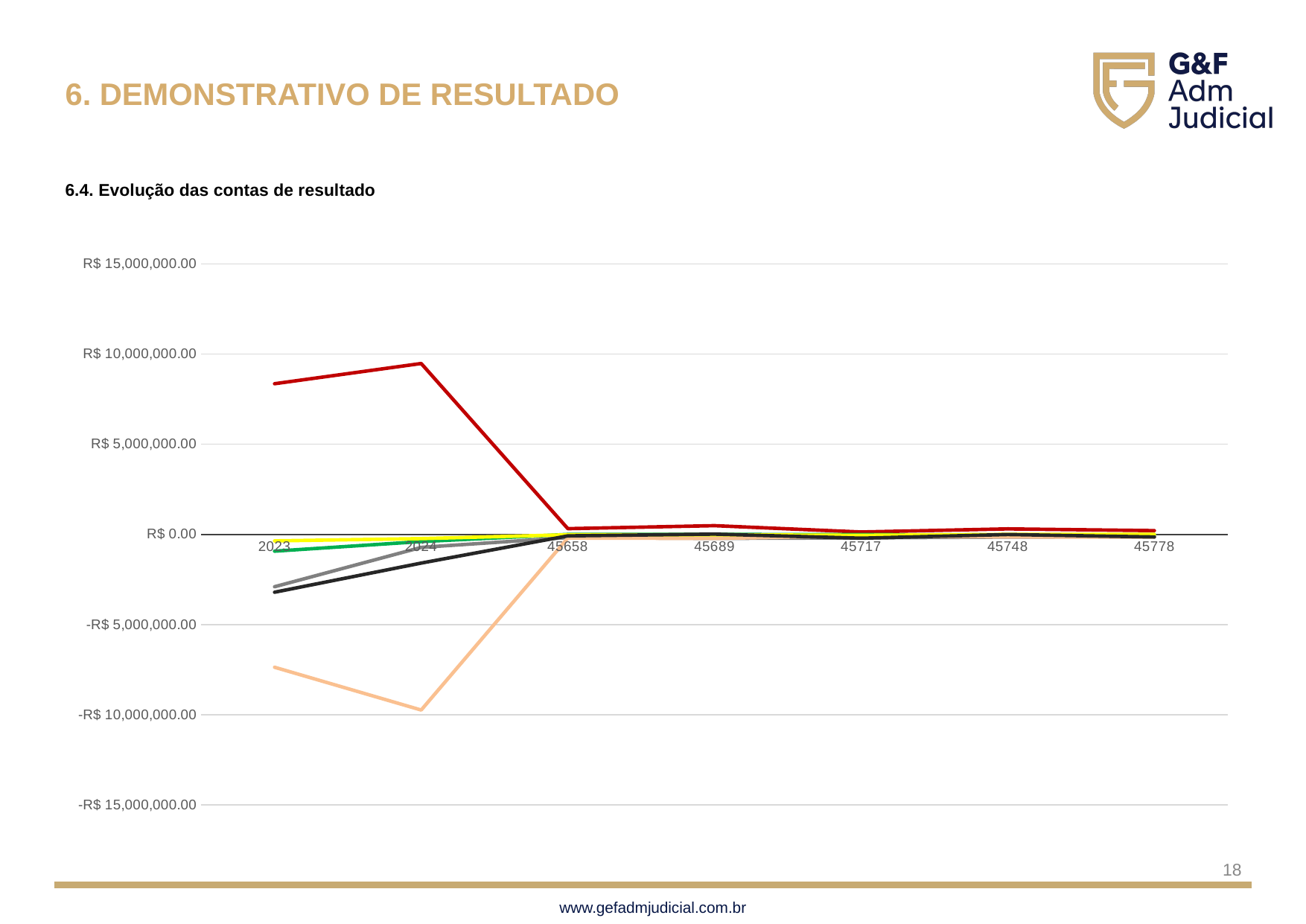
At which x-axis point does the light orange line reach its lowest value? 2024 What kind of chart is shown on the slide? Line chart Is the value of the red line at 45658 greater or less than R$ 5,000,000.00? less What is the highest value shown on the y axis of the chart? R$ 15,000,000.00 Is the value of the black line at 2023 greater or less than -R$ 5,000,000.00? greater At 2023, which line has the higher value, the red line or the light orange line? red line Is the value of the light orange line at 2024 greater or less than -R$ 5,000,000.00? less Does the red line rise or fall between 2024 and 45658? fall At which x-axis point does the red line reach its highest value? 2024 How many points are labelled along the x axis of the chart? 7 What is the first category label on the x axis of the chart? 2023